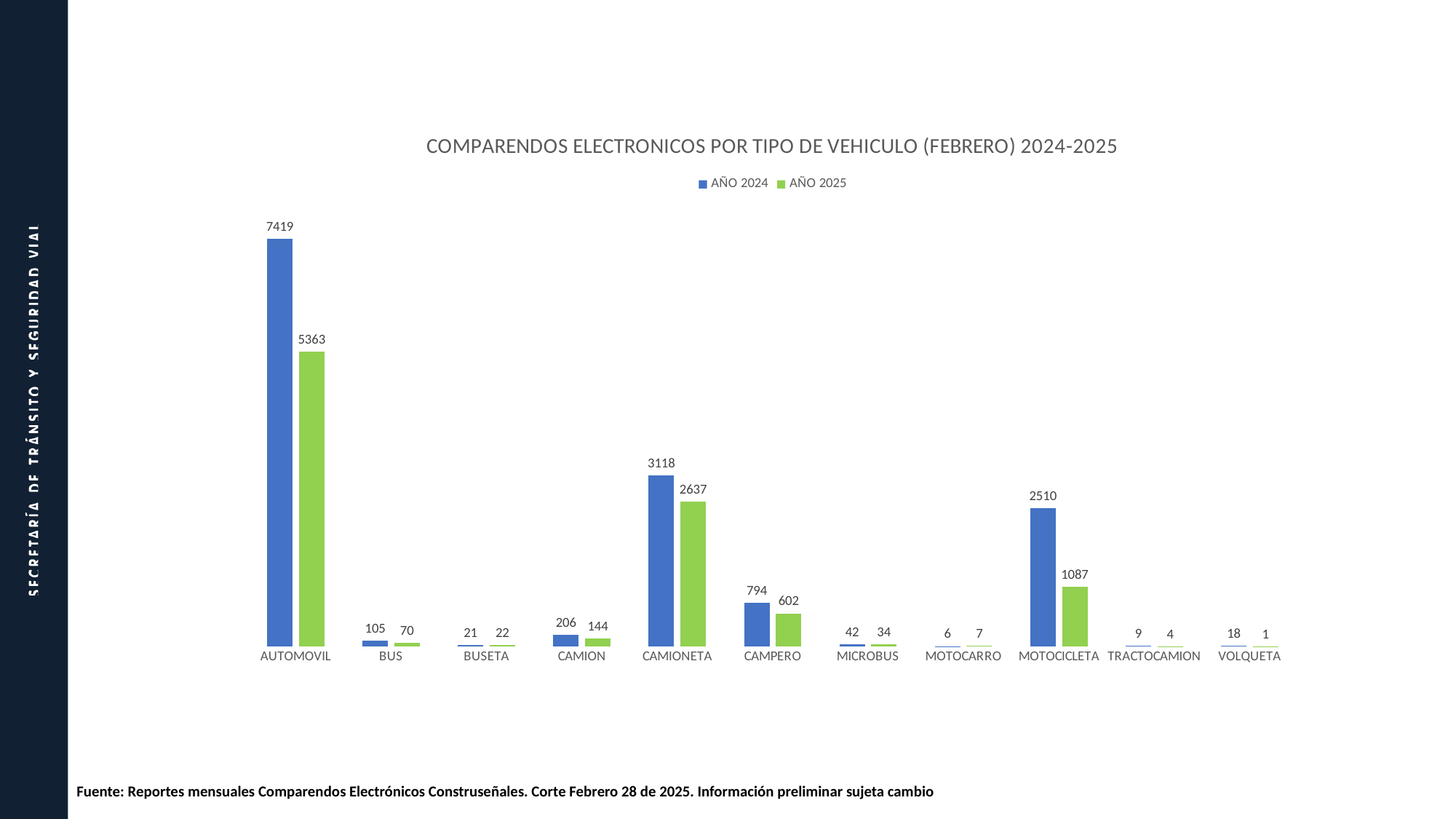
What is the value for AUTOMOVIL in the AÑO 2024 series? 7419 Which is larger for MOTOCARRO: the AÑO 2024 value or the AÑO 2025 value? AÑO 2025 How many series does the legend list? 2 How many vehicle types are shown on the x axis? 11 What is the value for CAMPERO in the AÑO 2024 series? 794 What is the difference between the AÑO 2024 and AÑO 2025 values for CAMIONETA? 481 What is the value for MOTOCICLETA in the AÑO 2025 series? 1087 What is the title of the chart? COMPARENDOS ELECTRONICOS POR TIPO DE VEHICULO (FEBRERO) 2024-2025 Which vehicle type has the lowest value in the AÑO 2025 series? VOLQUETA Which vehicle type has the highest value in the AÑO 2025 series? AUTOMOVIL What kind of chart is shown on the slide? Bar chart What is the difference between the AÑO 2024 and AÑO 2025 values for AUTOMOVIL? 2056